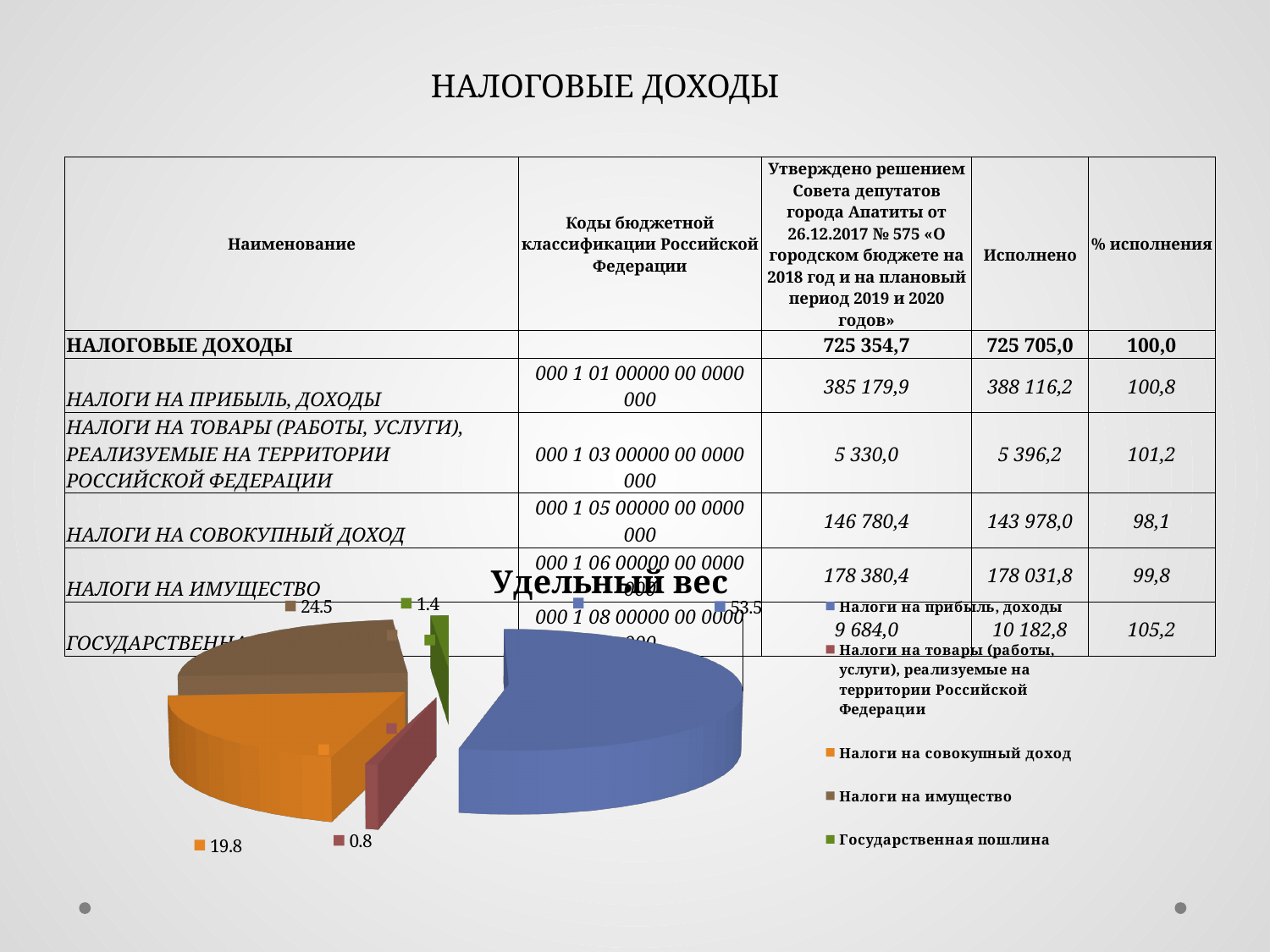
What type of chart is shown on the slide? pie chart What is the value shown for Государственная пошлина in the pie chart? 1.4 Which category has the largest slice in the pie chart? Налоги на прибыль, доходы What is the value shown for Налоги на прибыль, доходы in the pie chart? 53.5 How many slices does the pie chart have? 5 Which category has the smallest slice in the pie chart? Налоги на товары (работы, услуги), реализуемые на территории Российской Федерации How many entries does the chart legend list? 5 What is the difference between the values for Налоги на прибыль, доходы and Налоги на имущество in the pie chart? 29.0 What is the title of the chart on the slide? Удельный вес What is the value shown for Налоги на совокупный доход in the pie chart? 19.8 Which is larger in the pie chart: Налоги на имущество or Налоги на совокупный доход? Налоги на имущество What is the value shown for Налоги на имущество in the pie chart? 24.5